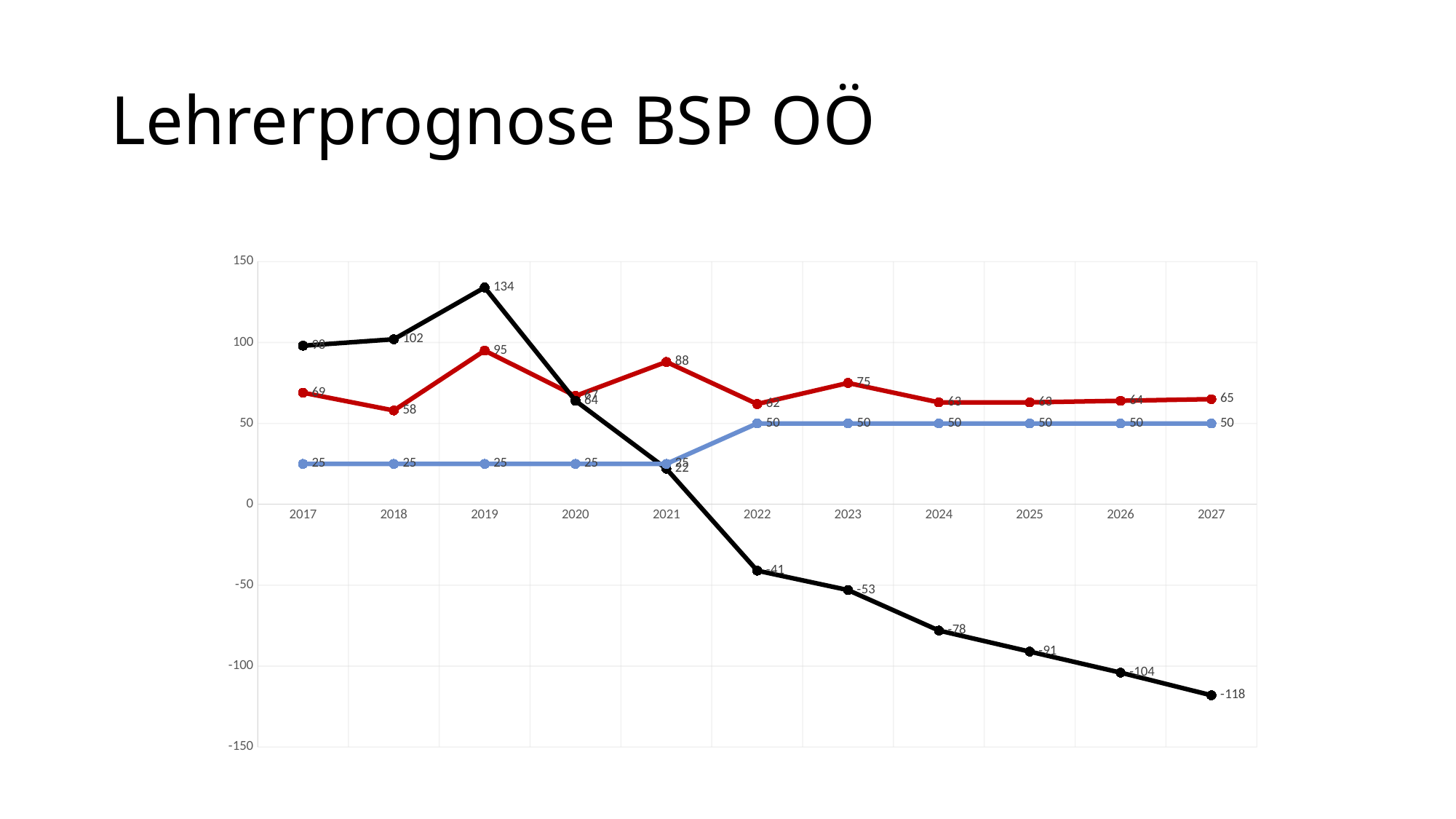
In which year does the black line reach its lowest value? 2027 What is the value of the red line in 2021? 88 Does the black line rise or fall from 2019 to 2027? fall What is the value of the black line in 2027? -118 What is the title of the slide? Lehrerprognose BSP OÖ In which year does the black line reach its highest value? 2019 What kind of chart is shown on the slide? line chart What is the value of the black line in 2019? 134 What is the value of the blue line in 2017? 25 What is the difference between the black line's values in 2019 and 2018? 32 How many years are shown on the x axis of the chart? 11 In 2023, which line has the larger value, the red line or the blue line? red line